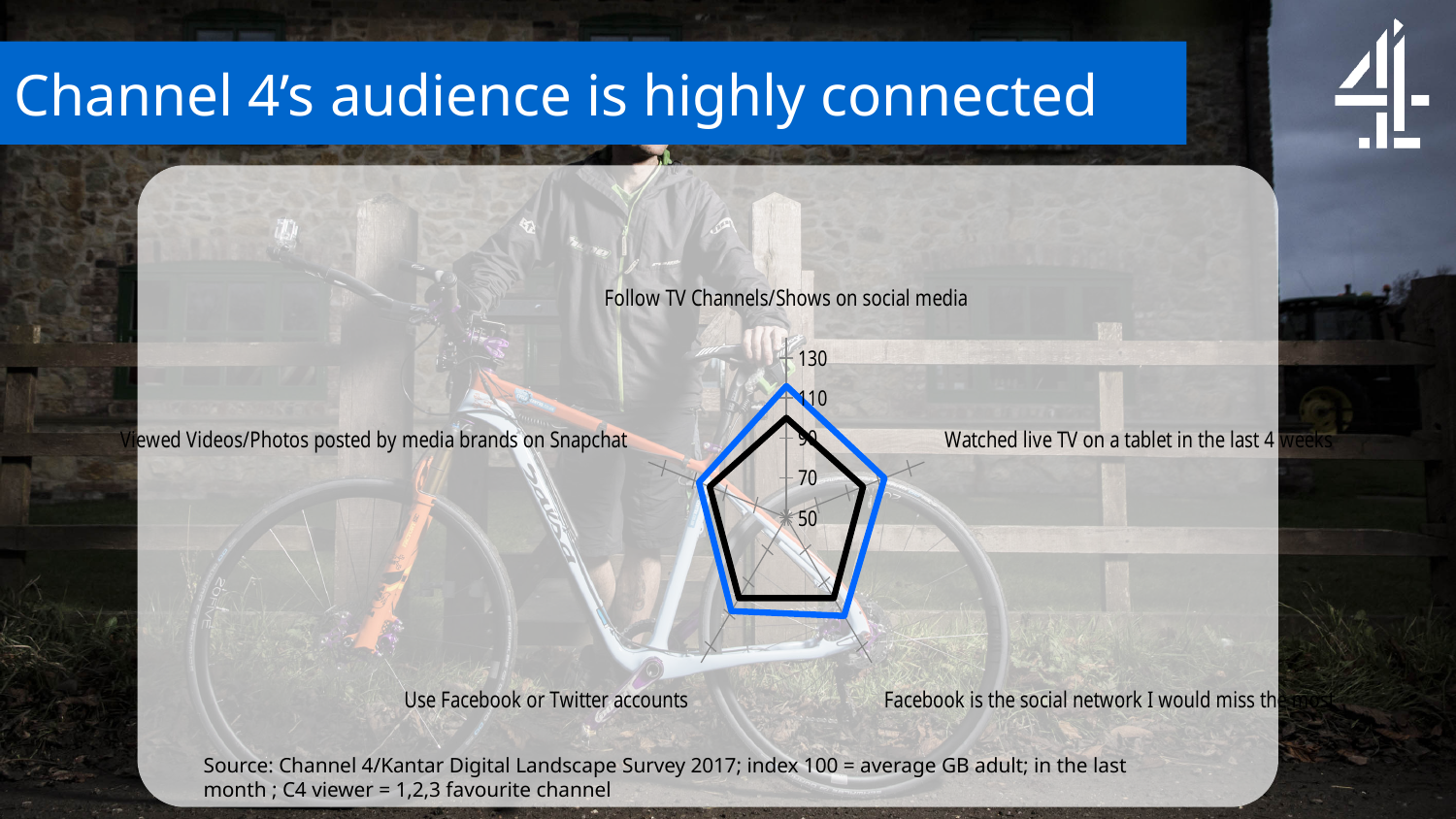
Which category label appears at the top of the radar chart? Follow TV Channels/Shows on social media What is the lowest value shown on the radar chart's axis scale? 50 For 'Facebook is the social network I would miss the most', which series has the larger value, the blue or the black one? Blue For 'Follow TV Channels/Shows on social media', which series has the larger value, the blue or the black one? Blue What is the highest value shown on the radar chart's axis scale? 130 Is the blue series value for 'Follow TV Channels/Shows on social media' greater or less than 90? greater What kind of chart is shown on the slide? Radar chart Is the blue series value for 'Viewed Videos/Photos posted by media brands on Snapchat' greater or less than 70? greater Is the black series value for 'Use Facebook or Twitter accounts' greater or less than 130? less How many categories (axes) does the radar chart have? 5